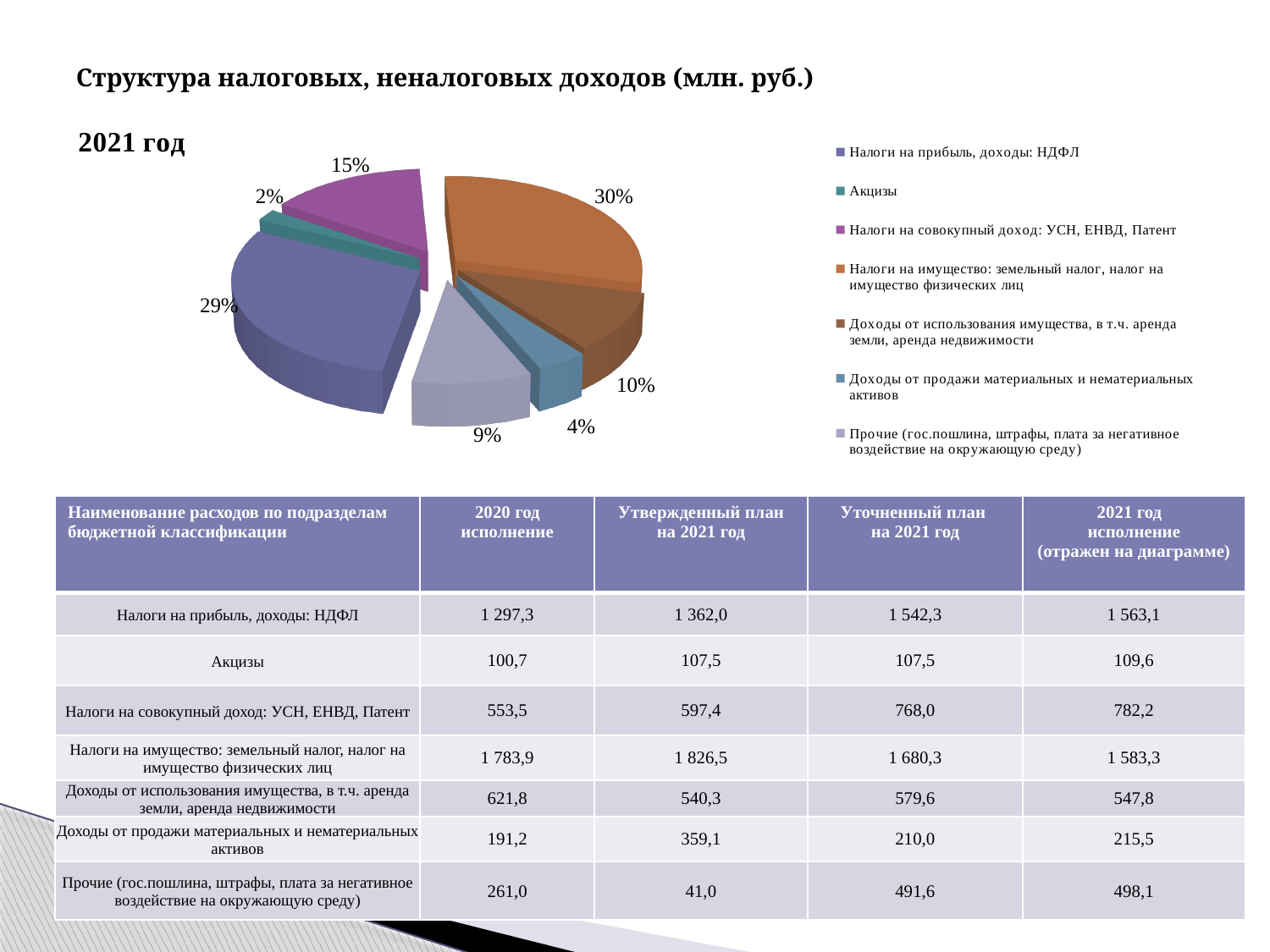
Which slice is larger: 'Доходы от использования имущества, в т.ч. аренда земли, аренда недвижимости' or 'Доходы от продажи материальных и нематериальных активов'? Доходы от использования имущества, в т.ч. аренда земли, аренда недвижимости What is the difference in percentage points between the 'Налоги на совокупный доход: УСН, ЕНВД, Патент' slice and the 'Прочие' slice? 6% Which category has the smallest slice of the pie chart? Акцизы Which category has the largest slice of the pie chart? Налоги на имущество: земельный налог, налог на имущество физических лиц What share of the pie does 'Налоги на прибыль, доходы: НДФЛ' have? 29% What share of the pie does 'Прочие (гос.пошлина, штрафы, плата за негативное воздействие на окружающую среду)' have? 9% What share of the pie does 'Акцизы' have? 2% What share of the pie does 'Налоги на имущество: земельный налог, налог на имущество физических лиц' have? 30% How many entries does the legend of the pie chart list? 7 How many slices does the pie chart have? 7 What share of the pie does 'Налоги на совокупный доход: УСН, ЕНВД, Патент' have? 15% What kind of chart is shown on the slide? Pie chart